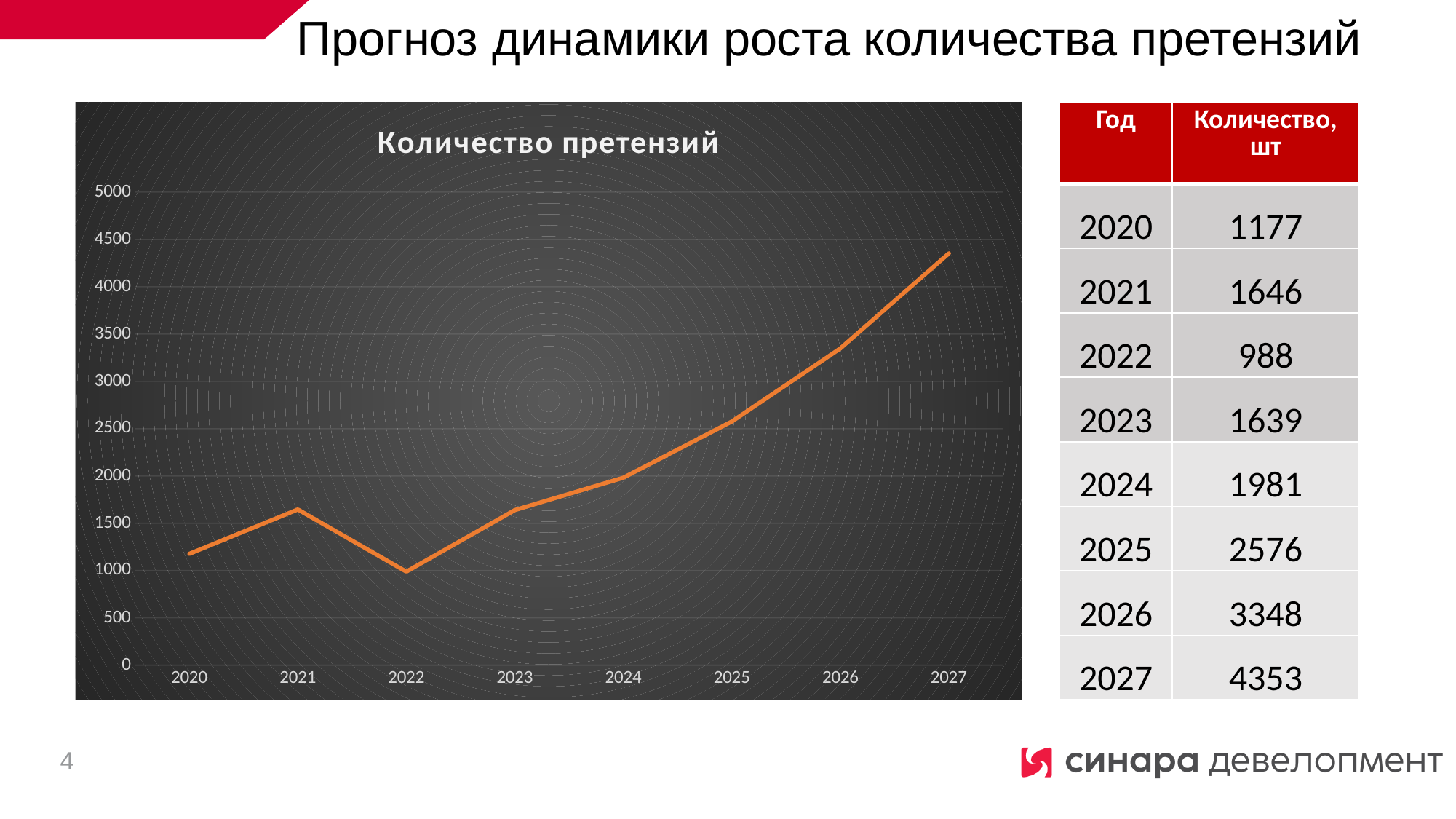
Which is larger, the value for 2021 or the value for 2022? 2021 Which year has the lowest number of claims? 2022 Do the values rise or fall from 2022 to 2027? rise Which year has the highest number of claims? 2027 Is the value for 2026 greater or less than 3000? greater Using the table values, what is the difference between the number of claims in 2027 and in 2026? 1005 How many years are plotted on the x axis of the chart? 8 What is the title of the chart? Количество претензий Is the value for 2022 greater or less than 1000? less According to the table, what is the number of claims in 2027? 4353 What kind of chart is shown on the slide? line chart According to the table, what is the number of claims in 2024? 1981